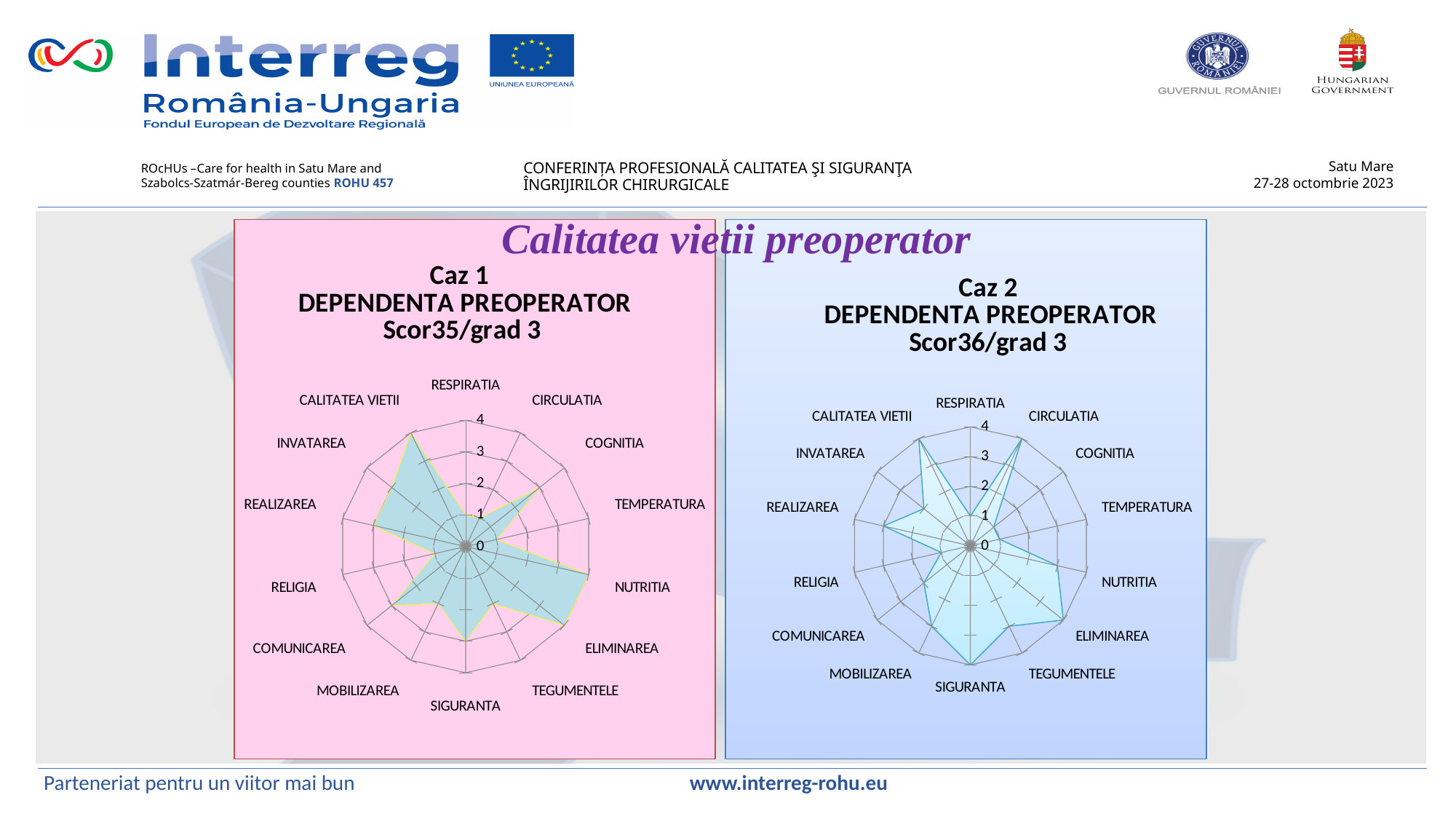
What kind of chart is the Caz 1 DEPENDENTA PREOPERATOR chart? Radar chart On the Caz 1 chart, is the value for NUTRITIA greater or less than 2? greater How many categories are plotted on the Caz 2 DEPENDENTA PREOPERATOR chart? 14 What is the maximum value shown on the axis of the Caz 2 chart? 4 How many categories are plotted on the Caz 1 DEPENDENTA PREOPERATOR chart? 14 On the Caz 2 chart, is the value for CIRCULATIA greater or less than 2? greater On the Caz 1 chart, is the value for RESPIRATIA greater or less than 2? less What kind of chart is the Caz 2 DEPENDENTA PREOPERATOR chart? Radar chart What score and grade are shown in the title of the Caz 1 chart? Scor35/grad 3